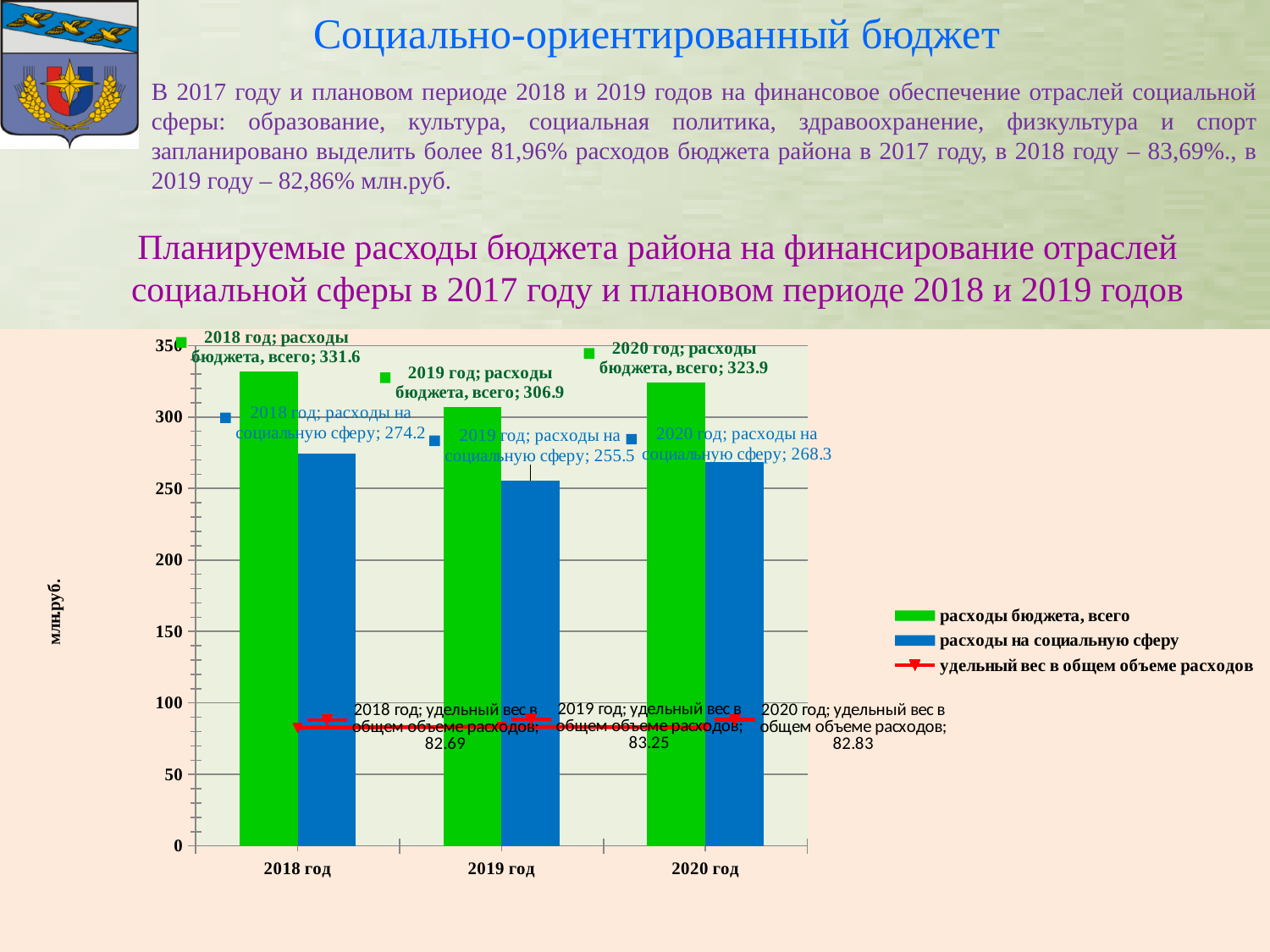
How many series does the chart legend list? 3 Which year has the lowest value for 'расходы на социальную сферу'? 2019 год Which is larger: 'расходы бюджета, всего' for 2019 год or for 2020 год? 2020 год Which year has the highest value for 'расходы бюджета, всего'? 2018 год What is the value of 'расходы бюджета, всего' for 2018 год? 331.6 Which year has the highest value for 'удельный вес в общем объеме расходов'? 2019 год What is the value of 'расходы на социальную сферу' for 2019 год? 255.5 What unit is shown on the vertical axis label of the chart? млн.руб. How many years are shown on the x axis of the chart? 3 What is the value of 'удельный вес в общем объеме расходов' for 2020 год? 82.83 What is the difference between 'расходы бюджета, всего' and 'расходы на социальную сферу' for 2020 год? 55.6 What kind of chart is used to show 'расходы бюджета, всего' and 'расходы на социальную сферу'? bar chart